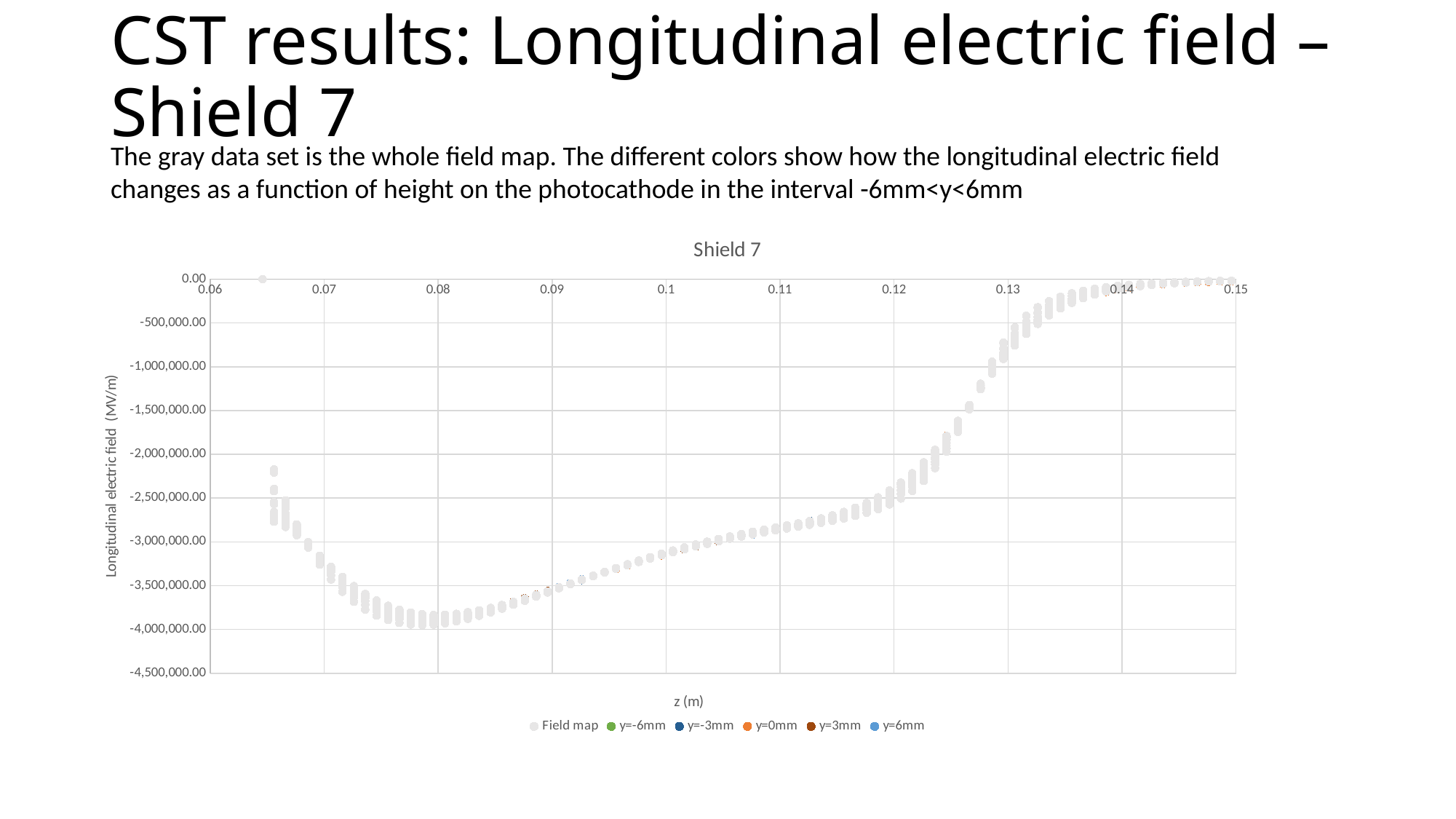
Do the Field map values rise or fall as z increases from 0.065 to 0.078? fall What kind of chart is shown on the slide? scatter chart Is the Field map value at z = 0.1 greater or less than -2,500,000.00? less Is the Field map value at z = 0.14 greater or less than -500,000.00? greater What is the lowest value shown on the y axis of the chart? -4,500,000.00 Is the Field map value at z = 0.11 greater or less than -3,500,000.00? greater Do the Field map values rise or fall as z increases from 0.08 to 0.15? rise How many series does the chart legend list? 6 What is the title of the chart? Shield 7 What is the label of the x axis of the chart? z (m) Which is larger, the Field map value at z = 0.13 or at z = 0.09? z = 0.13